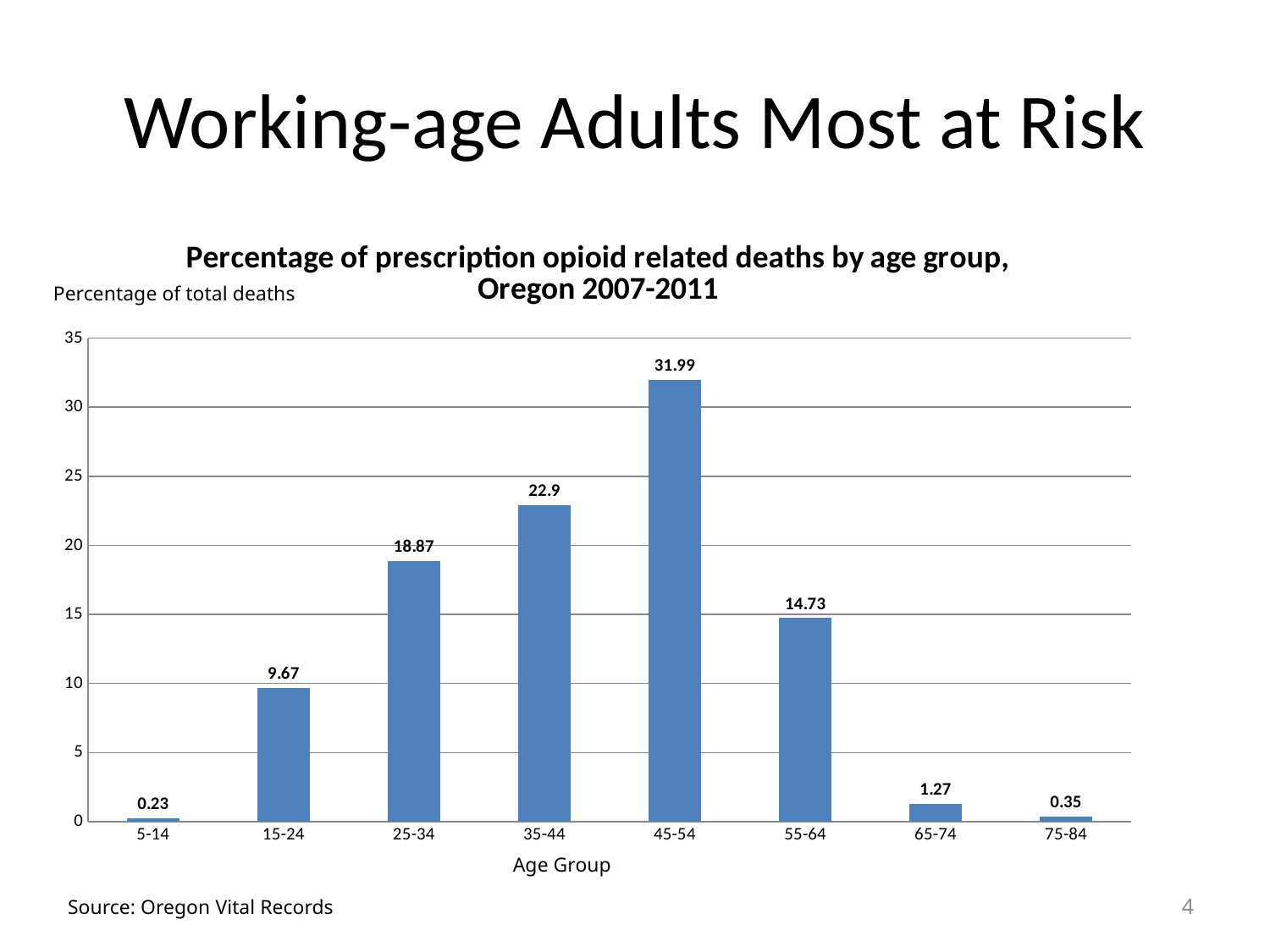
Which is larger, the value for 25-34 or the value for 55-64? 25-34 Which age group has the highest percentage of prescription opioid related deaths? 45-54 What is the difference between the values for the 25-34 and 15-24 age groups? 9.2 What kind of chart is shown on the slide? Bar chart What is the label on the x axis of the chart? Age Group What is the difference between the values for the 45-54 and 35-44 age groups? 9.09 How many age groups are shown on the chart? 8 Is the value for the 35-44 age group greater or less than 20? greater What is the value for the 45-54 age group? 31.99 Which age group has the lowest percentage of prescription opioid related deaths? 5-14 What is the value for the 15-24 age group? 9.67 What is the value for the 65-74 age group? 1.27